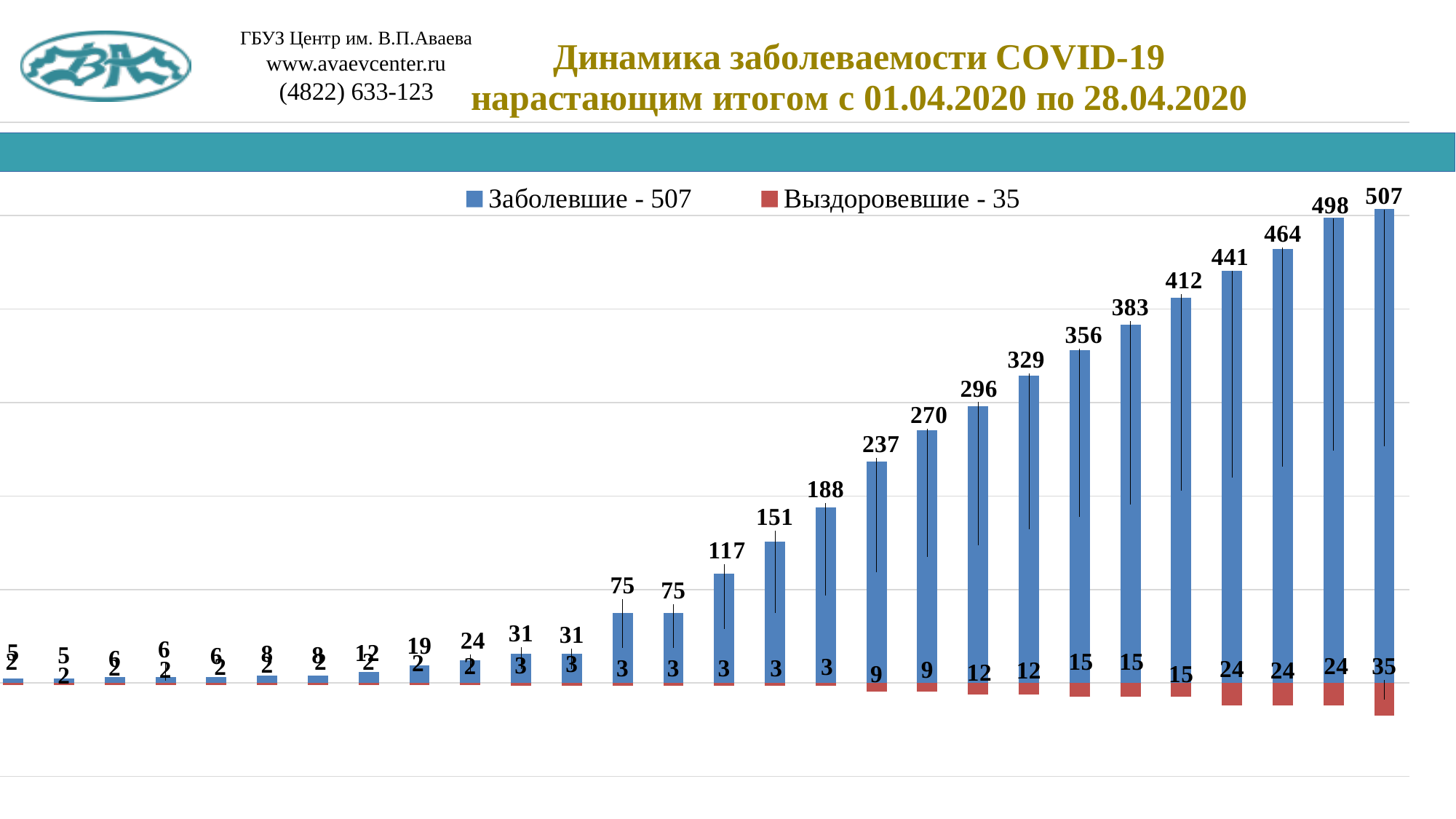
How many series does the legend list? 2 Do the Заболевшие values rise or fall from left to right along the x axis? rise What is the highest value reached by the Заболевшие series? 507 What is the lowest value shown for the Выздоровевшие series? 2 What is the difference between the final Заболевшие value (507) and the final Выздоровевшие value (35)? 472 What is the difference between the last two Заболевшие values, 507 and 498? 9 How many bars (days) are plotted for the Заболевшие series? 28 What is the title of the chart? Динамика заболеваемости COVID-19 нарастающим итогом с 01.04.2020 по 28.04.2020 Which series is shown in red in the legend? Выздоровевшие - 35 What is the highest value reached by the Выздоровевшие series? 35 What kind of chart is shown on the slide? bar chart What is the lowest value shown for the Заболевшие series? 5